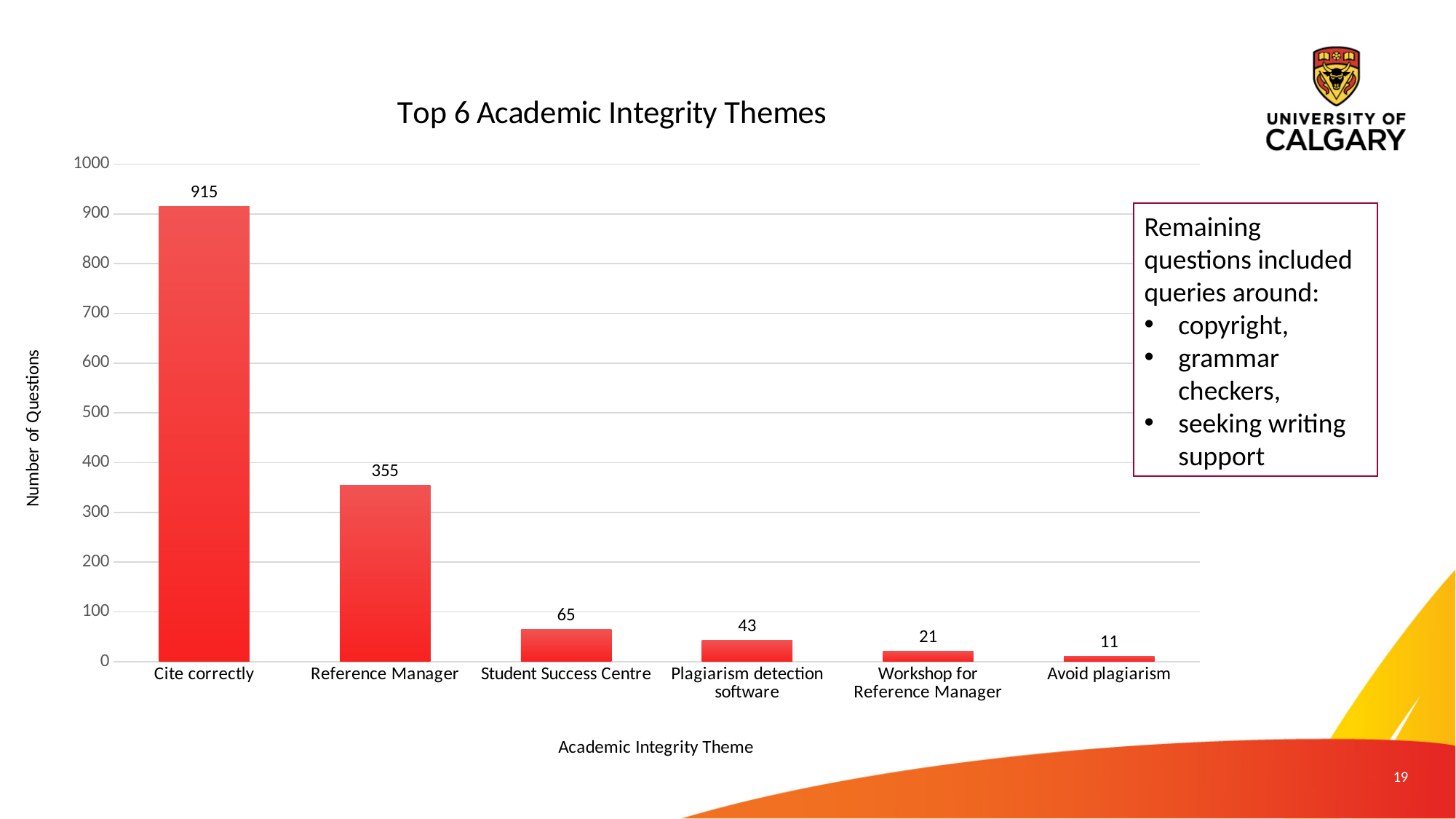
Is the value for Reference Manager greater or less than 300? greater What is the number of questions for Plagiarism detection software? 43 What is the number of questions for Cite correctly? 915 Which academic integrity theme has the lowest number of questions? Avoid plagiarism Which academic integrity theme has the highest number of questions? Cite correctly What is the number of questions for Reference Manager? 355 What kind of chart is shown on the slide? Bar chart What is the number of questions for Workshop for Reference Manager? 21 What is the title of the chart? Top 6 Academic Integrity Themes Which has more questions, Student Success Centre or Plagiarism detection software? Student Success Centre What is the difference in number of questions between Cite correctly and Reference Manager? 560 How many academic integrity themes are shown in the chart? 6